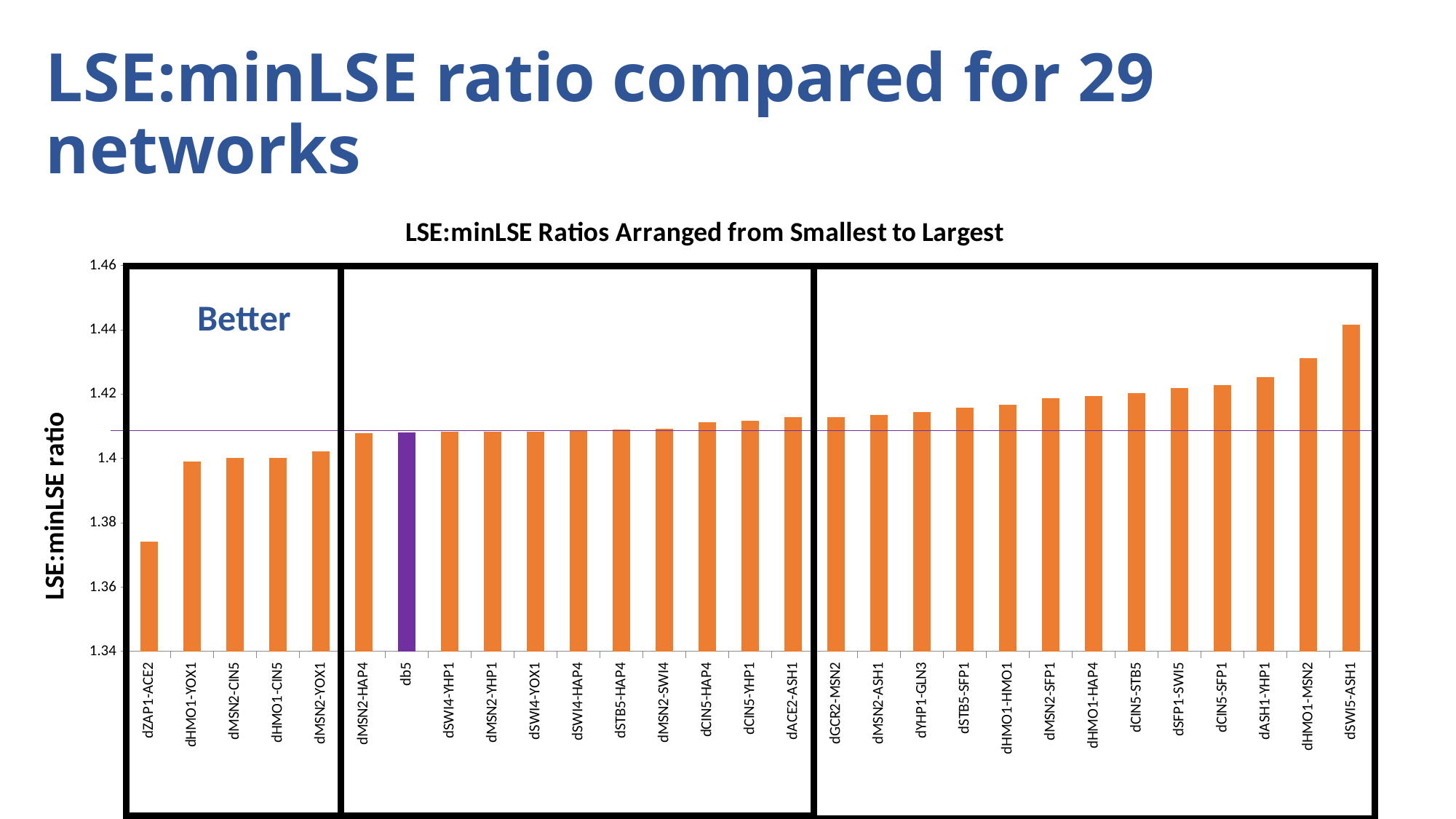
Is the value for dGCR2-MSN2 greater or less than 1.42? less Which bar is coloured purple instead of orange? db5 What kind of chart is shown on the slide? bar chart Which network has the highest LSE:minLSE ratio? dSWI5-ASH1 Is the value for dSWI5-ASH1 greater or less than 1.42? greater What is the title of the chart? LSE:minLSE Ratios Arranged from Smallest to Largest Which network has the lowest LSE:minLSE ratio? dZAP1-ACE2 Do the values rise or fall moving from left to right along the x axis? rise Is the value for dHMO1-MSN2 greater or less than 1.42? greater Which has the larger LSE:minLSE ratio, dSWI5-ASH1 or dHMO1-MSN2? dSWI5-ASH1 How many networks (bars) are plotted in the chart? 29